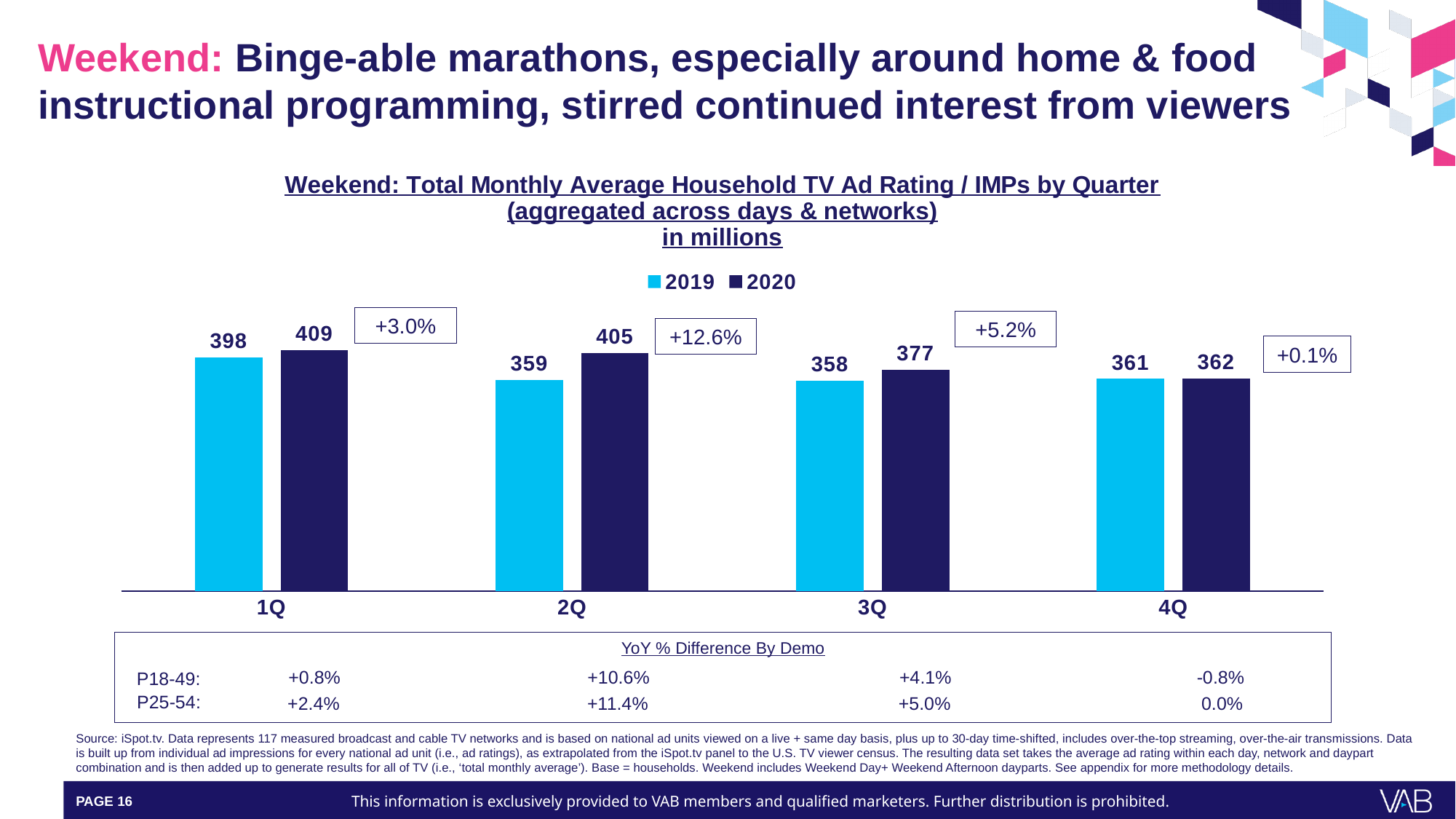
How many quarters are shown on the x axis? 4 Which series is shown in dark navy in the legend? 2020 What is the 2019 value for 3Q? 358 What is the 2020 value for 2Q? 405 Which quarter has the highest 2020 value? 1Q How many series does the legend list? 2 Which quarter has the lowest 2019 value? 3Q Which is larger, the 2019 value for 1Q or the 2019 value for 4Q? 2019 value for 1Q What is the 2019 value for 1Q? 398 What kind of chart is shown on the slide? Bar chart What year-over-year percentage change is shown for 3Q? +5.2% What is the difference between the 2020 and 2019 values for 2Q? 46